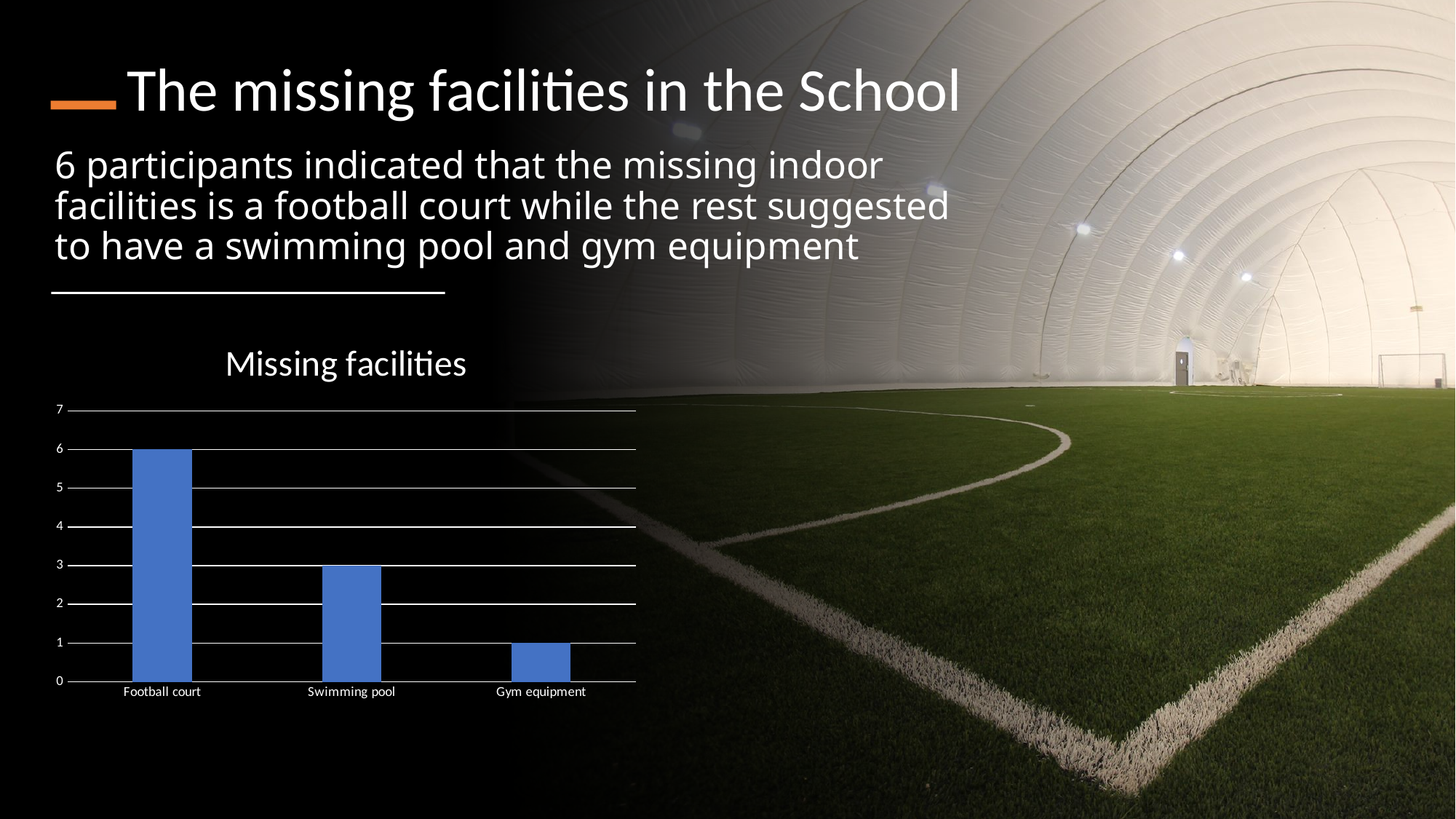
Which category has the lowest value? Gym equipment Is the value for Football court greater or less than 5? greater What is the value for Football court? 6 What is the value for Swimming pool? 3 What is the value for Gym equipment? 1 What is the title of the chart? Missing facilities What kind of chart is shown on the slide? Bar chart Which is larger, the value for Swimming pool or the value for Gym equipment? Swimming pool What is the difference between the values for Football court and Swimming pool? 3 How many categories are shown in the chart? 3 Do the values rise or fall from left to right across the categories? Fall Which category has the highest value? Football court